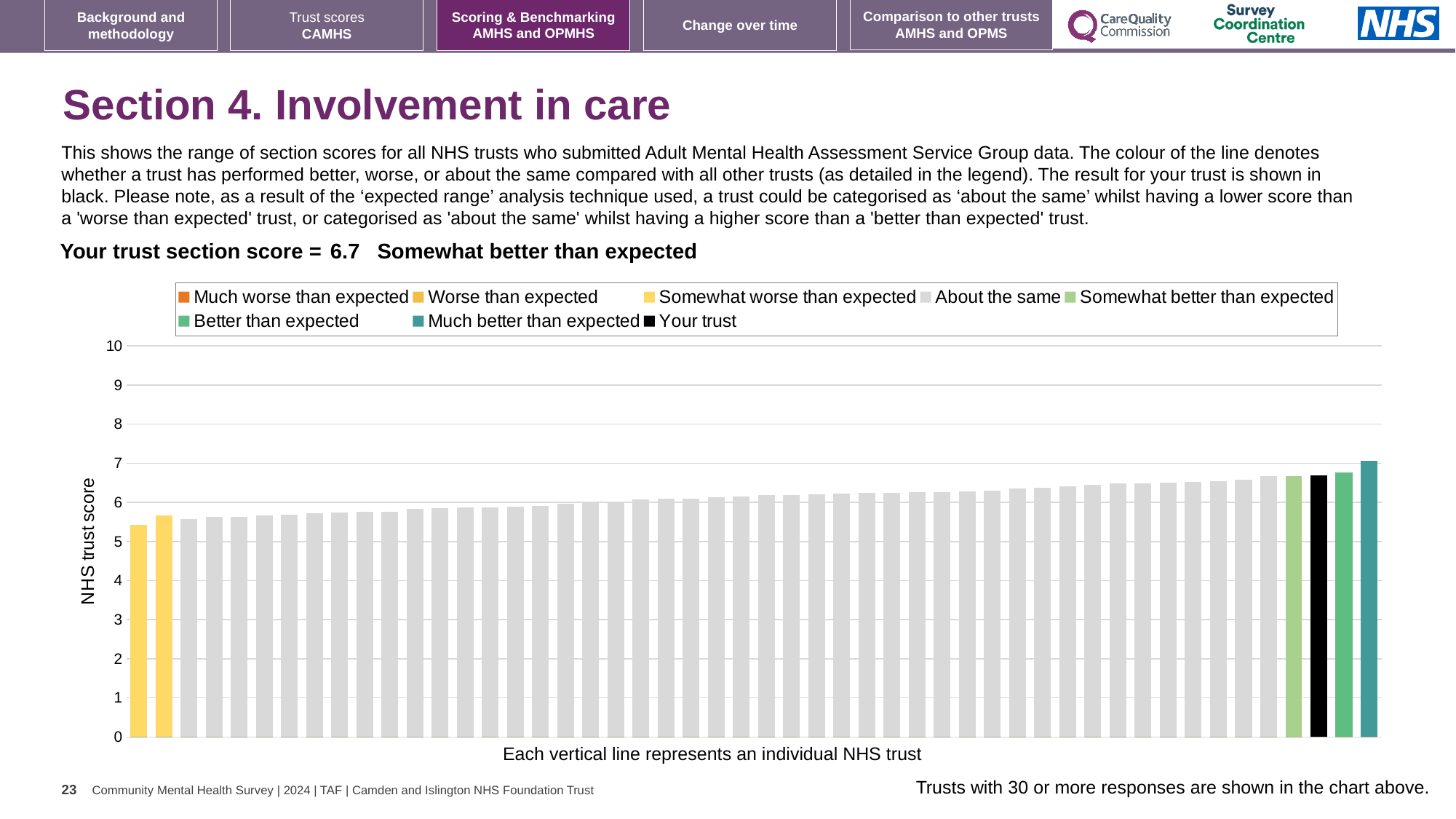
Is the value of the black 'Your trust' bar greater or less than 7? less What is the section score for your trust shown on the slide? 6.7 Which legend category does your trust's score fall into? Somewhat better than expected Which legend category does the shortest bar in the chart belong to? Somewhat worse than expected Which legend category does the tallest bar in the chart belong to? Much better than expected Do the bar values rise or fall from left to right along the x axis? rise How many bars in the chart are coloured yellow (Somewhat worse than expected)? 2 How many entries does the chart legend list? 8 Is the value of the black 'Your trust' bar greater or less than 6? greater Is the value of the lowest bar in the chart greater or less than 6? less What kind of chart is shown on the slide? bar chart